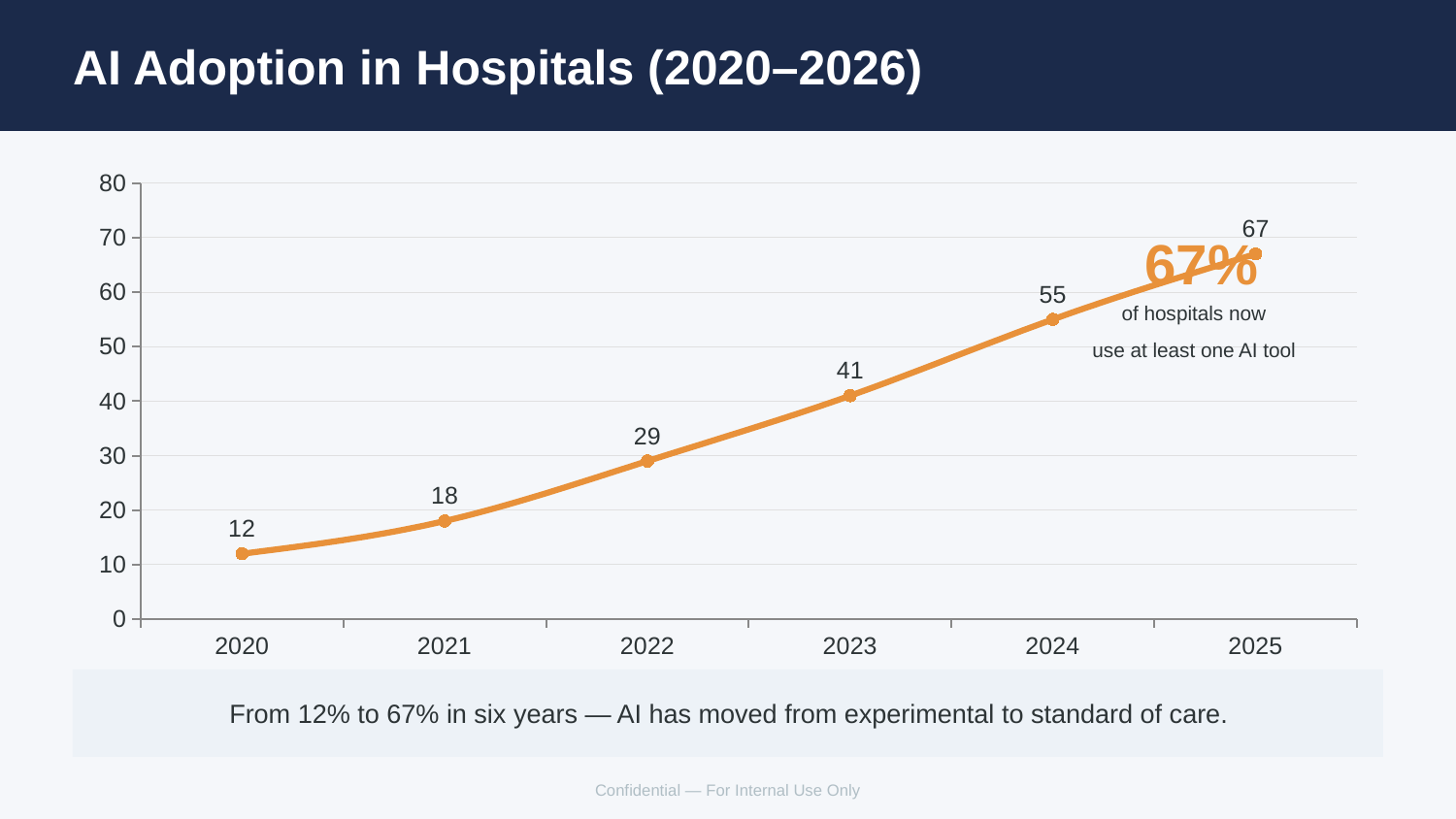
Do the values rise or fall from 2020 to 2025? rise What is the value for 2025? 67 Is the value for 2024 greater or less than 50? greater Which is larger, the value for 2022 or the value for 2023? 2023 What is the title of the chart? AI Adoption in Hospitals (2020–2026) How many years are plotted on the chart? 6 Which year has the highest value? 2025 Which year has the lowest value? 2020 What kind of chart is shown on the slide? line chart What is the value for 2023? 41 What is the difference between the values for 2024 and 2021? 37 What is the value for 2020? 12